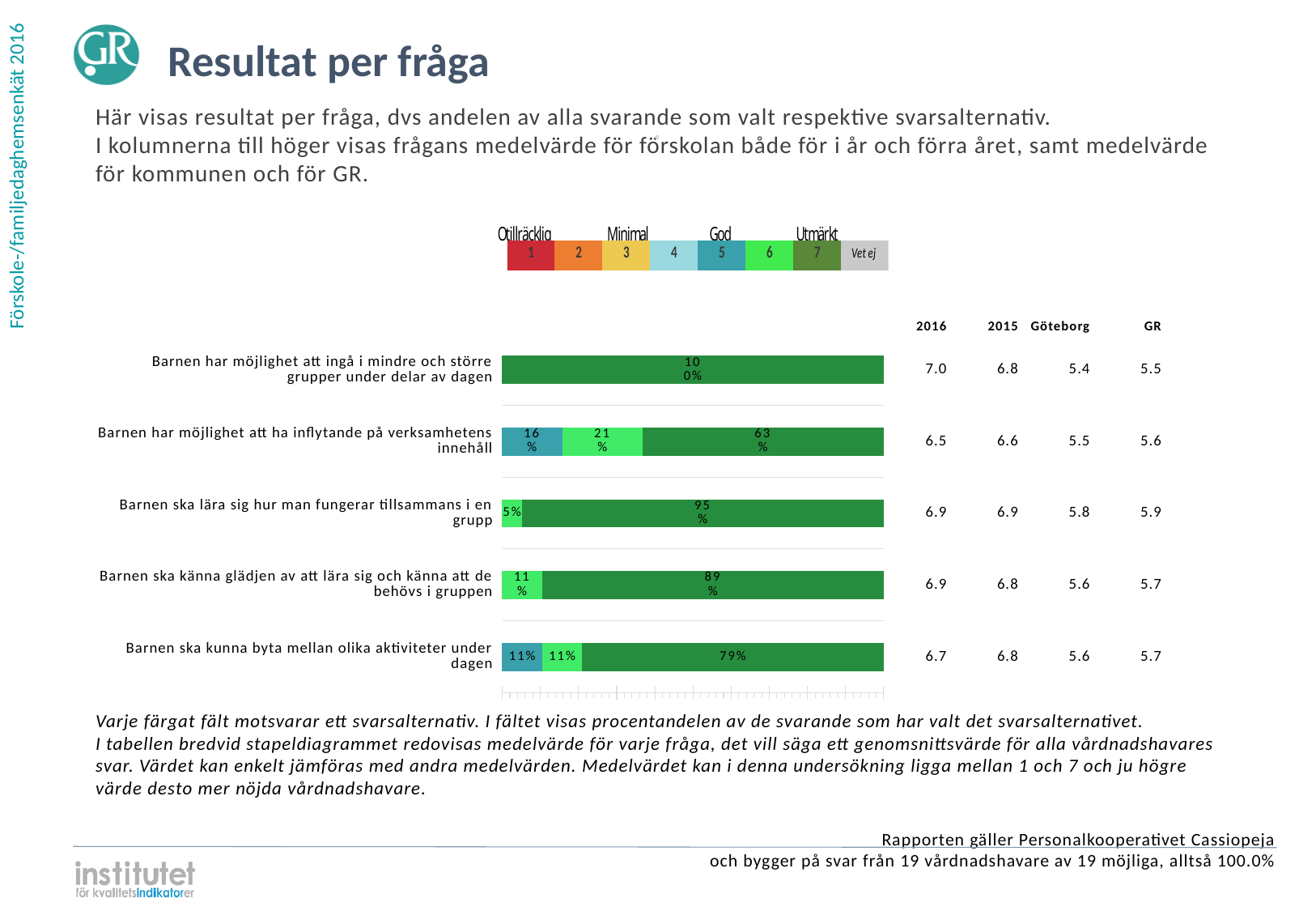
Which is larger: the share choosing alternative 6 for 'Barnen har möjlighet att ha inflytande på verksamhetens innehåll' or for 'Barnen ska känna glädjen av att lära sig och känna att de behövs i gruppen'? Barnen har möjlighet att ha inflytande på verksamhetens innehåll What is the 2016 mean value shown for 'Barnen har möjlighet att ingå i mindre och större grupper under delar av dagen'? 7.0 Which question has the smallest share of respondents choosing alternative 7? Barnen har möjlighet att ha inflytande på verksamhetens innehåll What is the difference between the share choosing alternative 7 for 'Barnen ska lära sig hur man fungerar tillsammans i en grupp' (95%) and for 'Barnen ska känna glädjen av att lära sig och känna att de behövs i gruppen' (89%)? 6% What percentage chose alternative 5 for 'Barnen har möjlighet att ha inflytande på verksamhetens innehåll'? 16% What is the combined share of alternatives 5 and 6 for 'Barnen ska kunna byta mellan olika aktiviteter under dagen'? 22% What percentage of respondents chose the highest alternative (7) for 'Barnen har möjlighet att ingå i mindre och större grupper under delar av dagen'? 100% What kind of chart is shown on the slide? Stacked bar chart How many answer alternatives does the colour legend above the chart list? 8 How many questions (categories) are plotted in the bar chart? 5 What percentage chose alternative 7 for 'Barnen ska lära sig hur man fungerar tillsammans i en grupp'? 95% What percentage chose alternative 7 for 'Barnen ska kunna byta mellan olika aktiviteter under dagen'? 79%